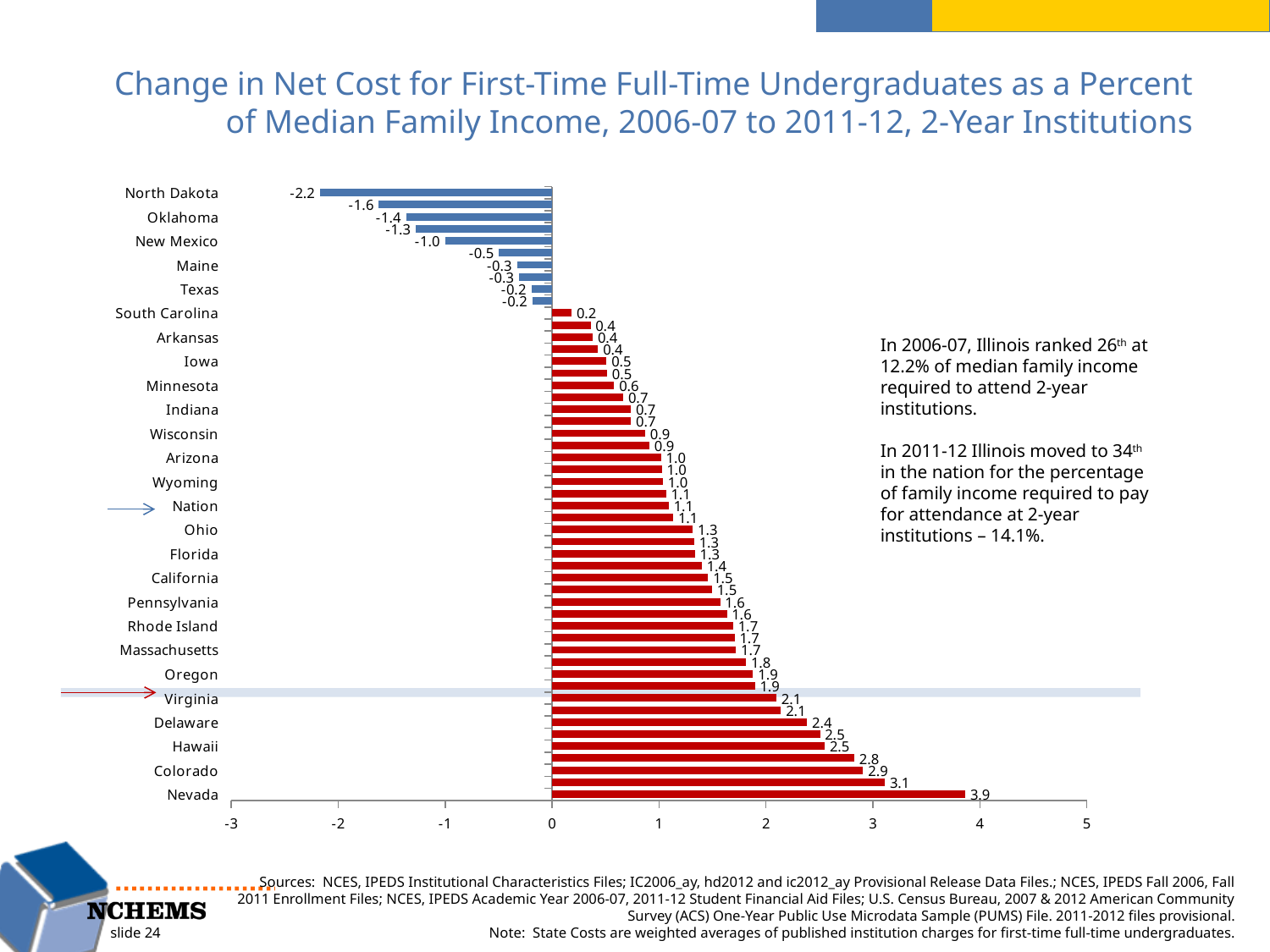
What is the difference between the values for Nevada and North Dakota? 6.1 What is the value shown for Virginia? 2.1 Which category has the highest value in the chart? Nevada Which has a larger value, Nevada or Colorado? Nevada What is the value shown for North Dakota? -2.2 Is the value for Delaware greater or less than 2? greater What is the value shown for Colorado? 2.9 What is the value shown for Nevada? 3.9 What is the value shown for the Nation? 1.1 Which category has the lowest value in the chart? North Dakota What kind of chart is shown on the slide? Bar chart What is the title of the chart? Change in Net Cost for First-Time Full-Time Undergraduates as a Percent of Median Family Income, 2006-07 to 2011-12, 2-Year Institutions